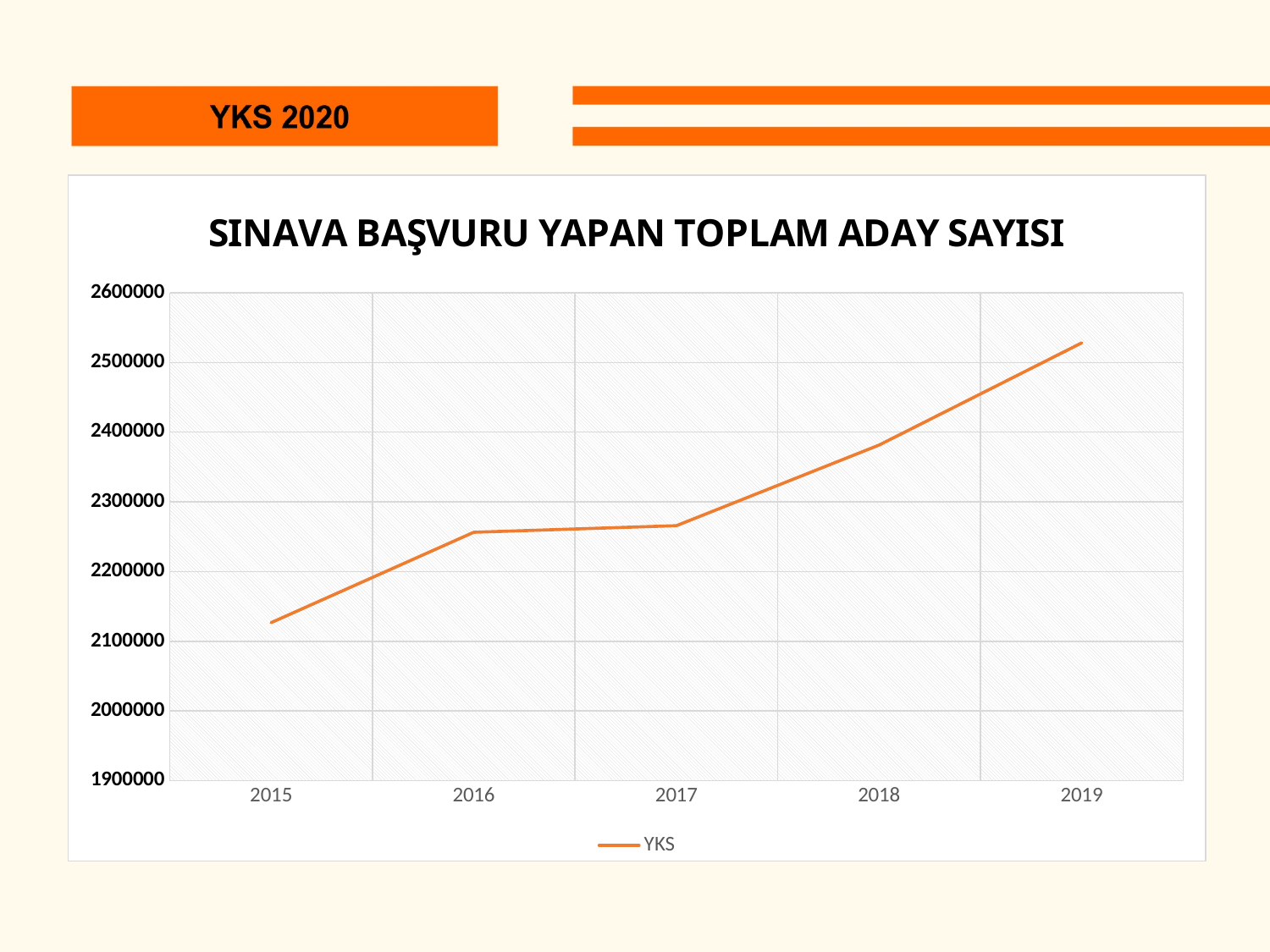
Is the value for 2018 greater or less than 2300000? greater Which year has the lowest value? 2015 Which year has the highest value? 2019 Is the value for 2015 greater or less than 2200000? less Which is larger, the value for 2016 or the value for 2018? 2018 How many series does the legend list? 1 What is the name of the series shown in the legend? YKS Is the value for 2019 greater or less than 2500000? greater How many years are plotted on the x axis? 5 What kind of chart is shown on the slide? line chart Do the values generally rise or fall from 2015 to 2019? rise What is the title of the chart? SINAVA BAŞVURU YAPAN TOPLAM ADAY SAYISI